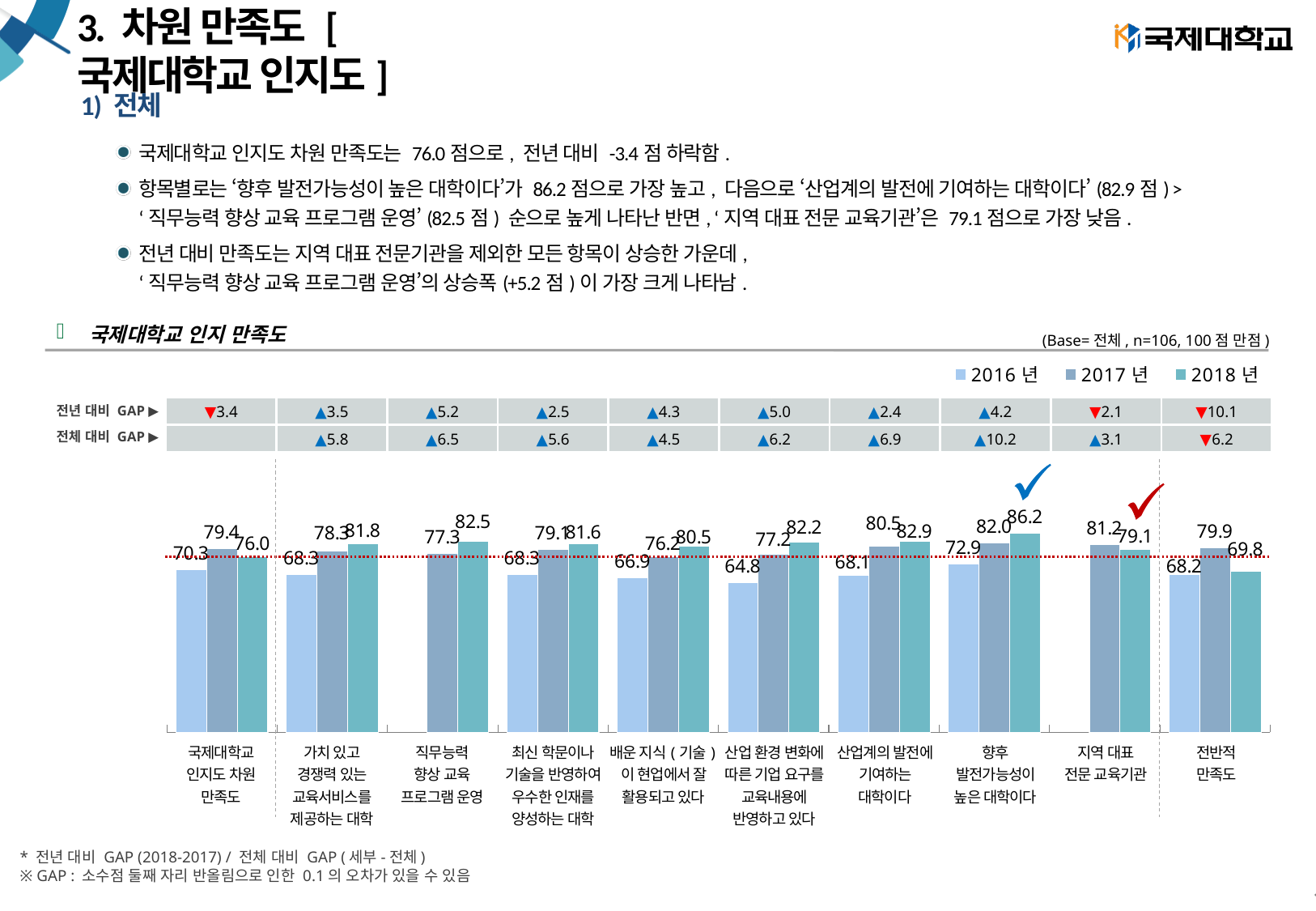
What is the 2016년 value for '국제대학교 인지도 차원 만족도'? 70.3 For '산업계의 발전에 기여하는 대학이다', do the values rise or fall from 2016년 to 2018년? Rise What is the 2018년 value for '전반적 만족도'? 69.8 What is the difference between the 2018년 and 2017년 values for '직무능력 향상 교육 프로그램 운영'? 5.2 What kind of chart is shown on the slide? Bar chart What is the 2018년 value for '향후 발전가능성이 높은 대학이다'? 86.2 How many series does the legend list? 3 Which is larger for '지역 대표 전문 교육기관': the 2017년 value or the 2018년 value? 2017년 What is the 2017년 value for '지역 대표 전문 교육기관'? 81.2 What is the 전년 대비 GAP shown for '전반적 만족도'? ▼10.1 Which category has the lowest 2016년 value? 산업 환경 변화에 따른 기업 요구를 교육내용에 반영하고 있다 Which category has the highest 2018년 value? 향후 발전가능성이 높은 대학이다